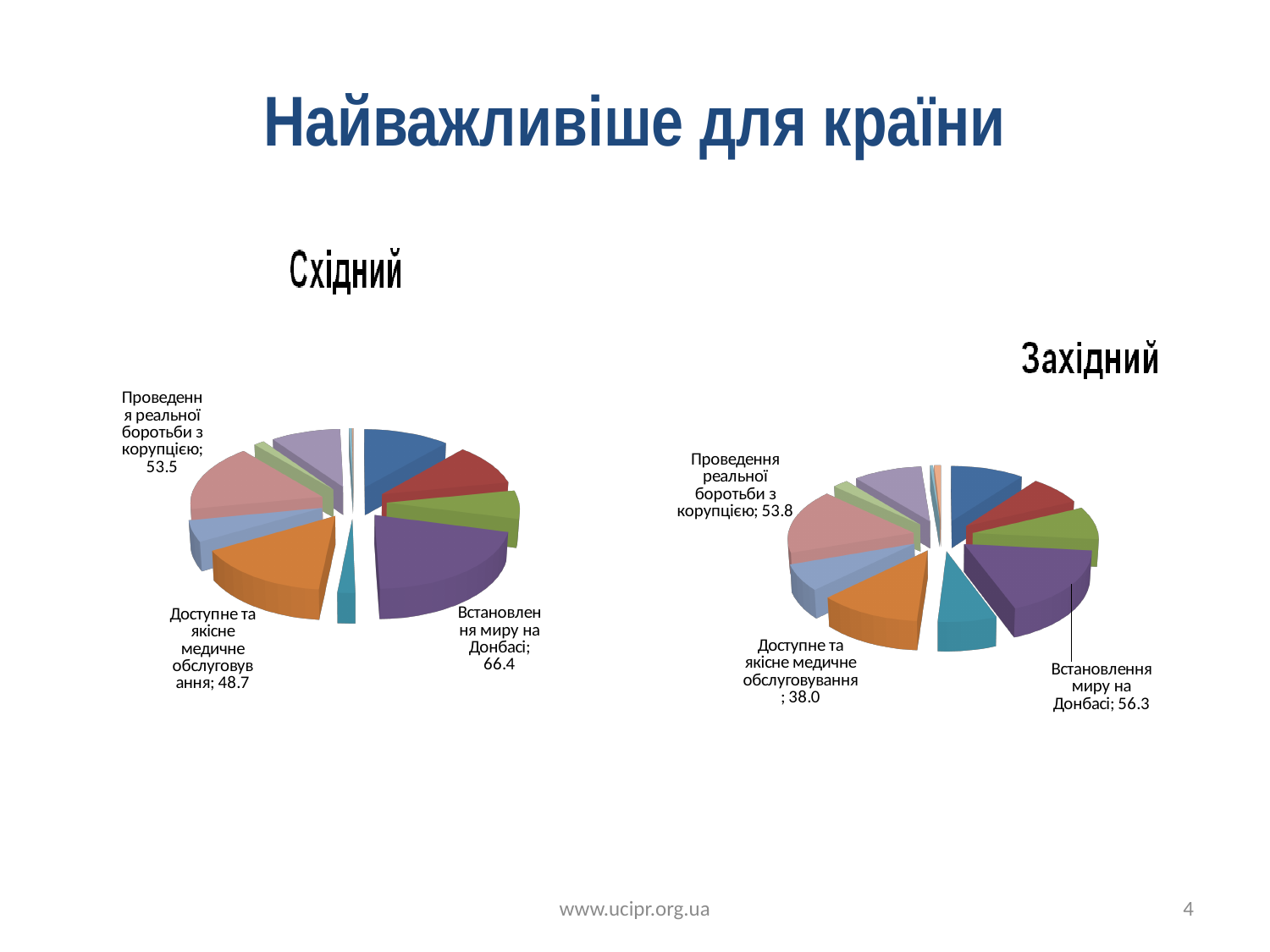
In the Східний chart, what value is shown for Доступне та якісне медичне обслуговування? 48.7 In the Західний chart, what is the difference between the values for Проведення реальної боротьби з корупцією and Доступне та якісне медичне обслуговування? 15.8 What is the difference between the Доступне та якісне медичне обслуговування values in the Східний and Західний charts? 10.7 What type of chart is used for the Східний and Західний data? Pie chart In the Східний chart, what is the difference between the values for Встановлення миру на Донбасі and Проведення реальної боротьби з корупцією? 12.9 In the Західний chart, what value is shown for Проведення реальної боротьби з корупцією? 53.8 In the Східний chart, what value is shown for Проведення реальної боротьби з корупцією? 53.5 Which chart shows a higher value for Встановлення миру на Донбасі, Східний or Західний? Східний In the Східний chart, what value is shown for Встановлення миру на Донбасі? 66.4 In the Західний chart, which is larger: Проведення реальної боротьби з корупцією or Доступне та якісне медичне обслуговування? Проведення реальної боротьби з корупцією In the Західний chart, what value is shown for Встановлення миру на Донбасі? 56.3 In the Західний chart, what value is shown for Доступне та якісне медичне обслуговування? 38.0